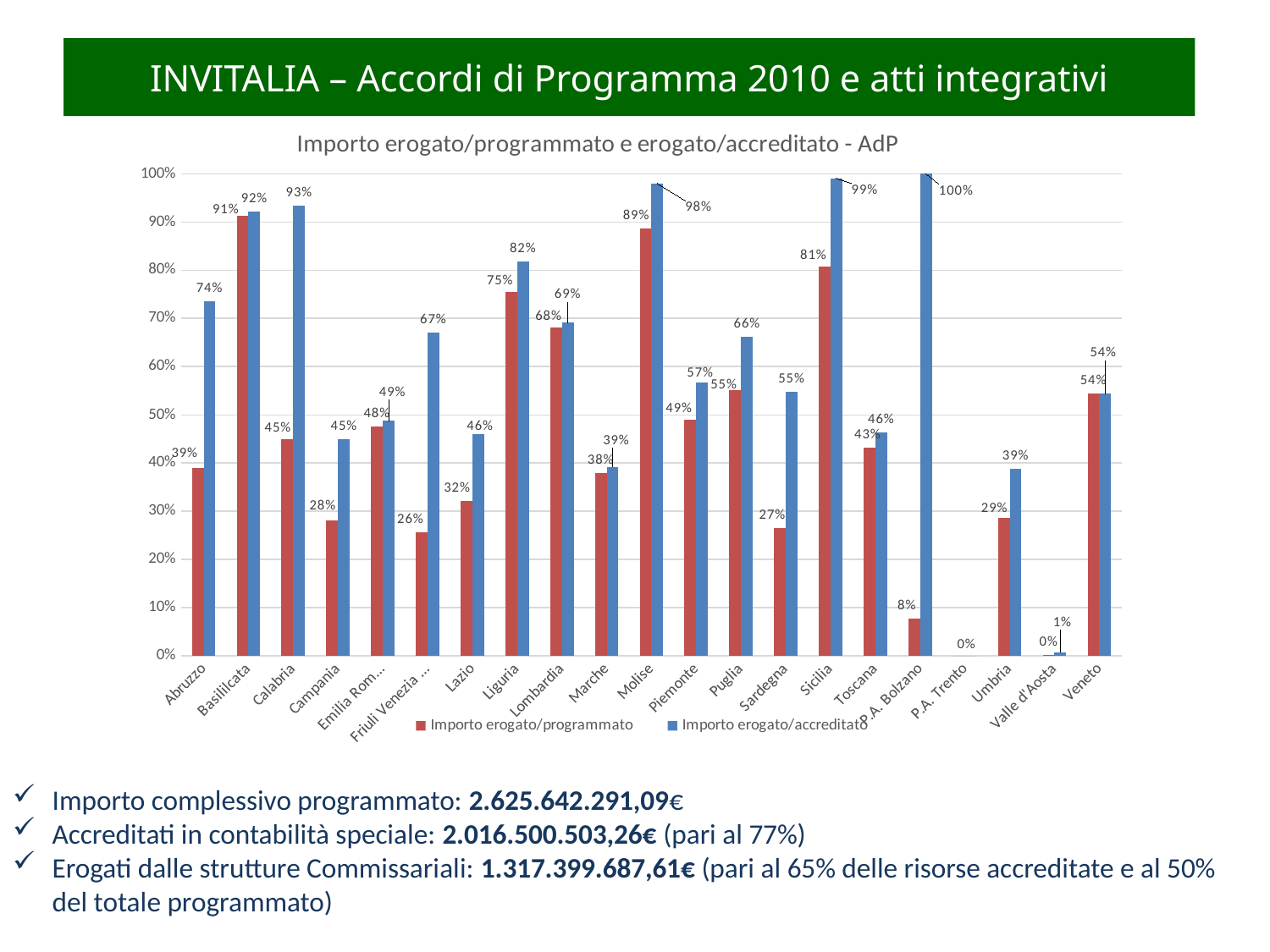
Which region has the highest value for Importo erogato/programmato? Basilicata Which region has the highest value for Importo erogato/accreditato? P.A. Bolzano What type of chart is shown on the slide? Bar chart How many series does the chart legend list? 2 What is the difference between Importo erogato/accreditato and Importo erogato/programmato for Calabria? 48% How many regions are shown on the x axis of the chart? 21 What is the value of Importo erogato/programmato for Sardegna? 27% What is the value of Importo erogato/accreditato for Abruzzo? 74% Is the value of Importo erogato/programmato for Liguria greater or less than 70%? greater Which is larger for Sicilia: Importo erogato/programmato or Importo erogato/accreditato? Importo erogato/accreditato What is the value of Importo erogato/programmato for Molise? 89% What is the value of Importo erogato/accreditato for Friuli Venezia Giulia? 67%